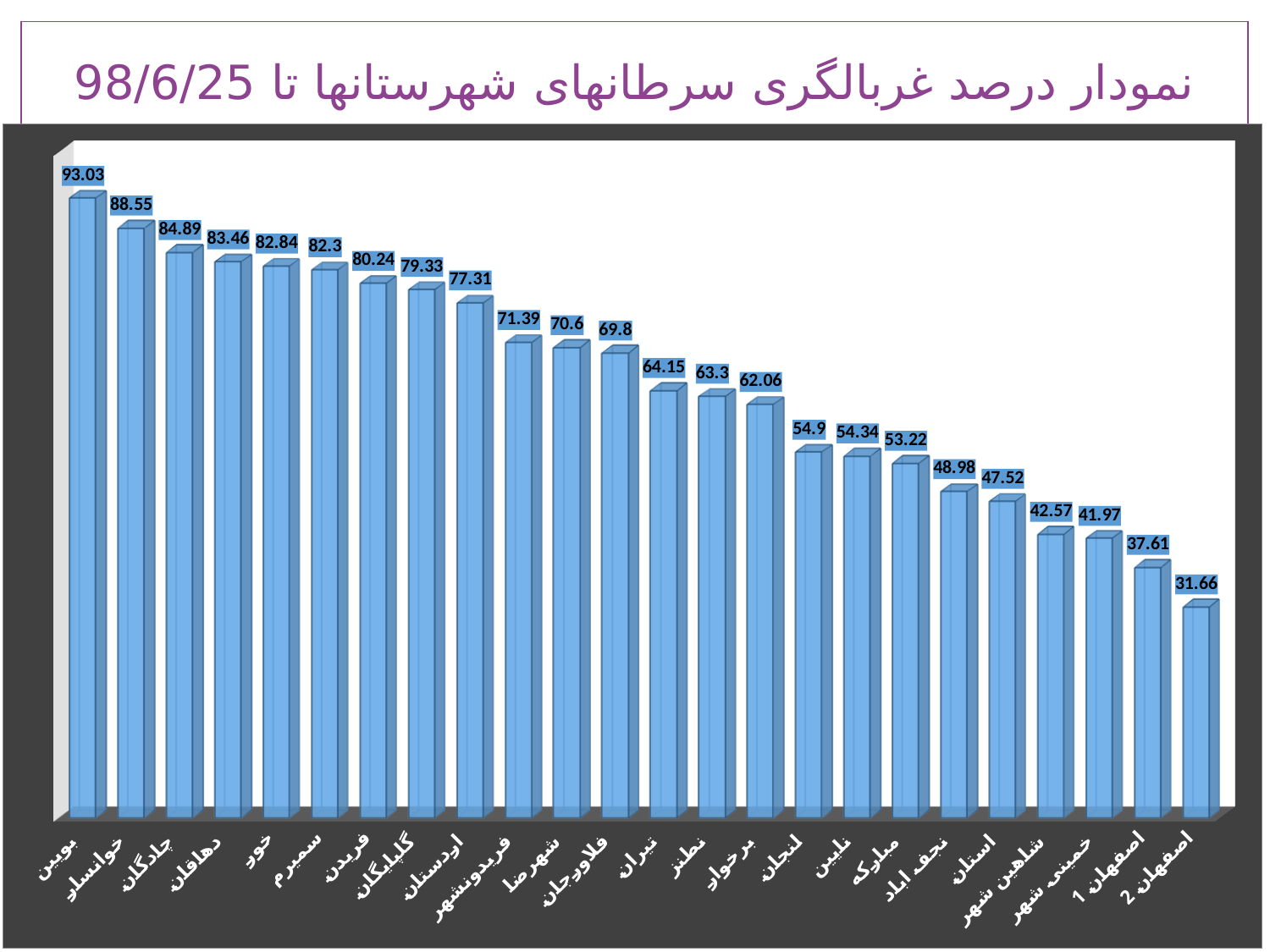
What is the difference between the values for خوانسار and چادگان? 3.66 How many categories are shown on the chart? 24 Which category has the lowest value? اصفهان 2 What kind of chart is shown on the slide? Bar chart What is the value shown for بویین? 93.03 Which is larger, the value for تیران or the value for لنجان? تیران Do the values rise or fall from left to right along the x axis? Fall What is the value shown for فلاورجان? 69.8 What is the value shown for اصفهان 2? 31.66 What is the value shown for استان? 47.52 What is the difference between the values for اصفهان 1 and اصفهان 2? 5.95 Which category has the highest value? بویین